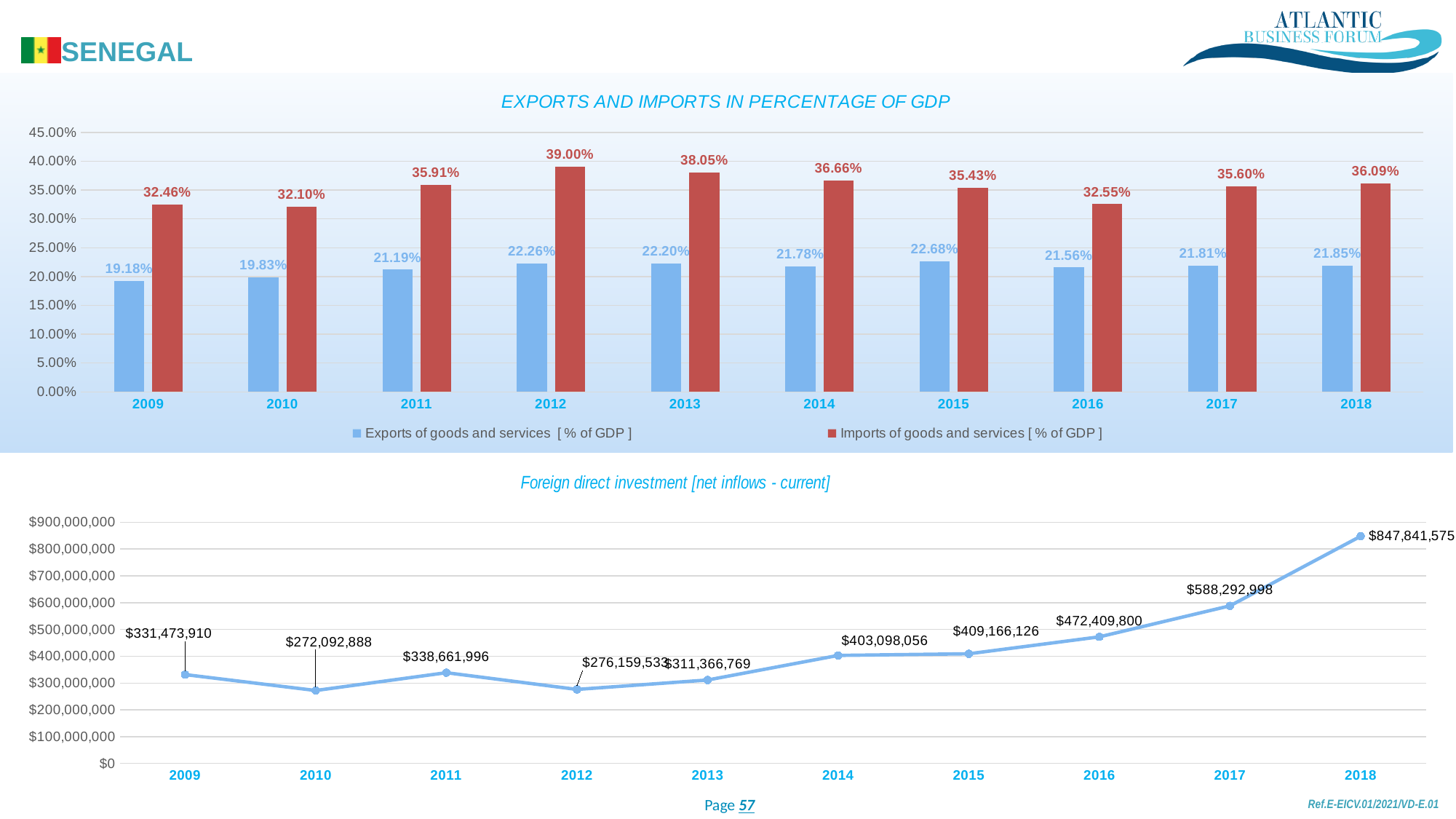
In the 'EXPORTS AND IMPORTS IN PERCENTAGE OF GDP' chart, what is the difference between imports and exports in 2012? 16.74% In the 'EXPORTS AND IMPORTS IN PERCENTAGE OF GDP' chart, what is the value of imports of goods and services in 2012? 39.00% In the 'EXPORTS AND IMPORTS IN PERCENTAGE OF GDP' chart, which year has the highest imports value? 2012 In the 'Foreign direct investment [net inflows - current]' chart, what is the value for 2018? $847,841,575 In the 'Foreign direct investment [net inflows - current]' chart, do the values rise or fall from 2013 to 2018? Rise In the 'Foreign direct investment [net inflows - current]' chart, how many years are plotted? 10 What type of chart is the 'EXPORTS AND IMPORTS IN PERCENTAGE OF GDP' chart? Bar chart In the 'EXPORTS AND IMPORTS IN PERCENTAGE OF GDP' chart, how many series does the legend list? 2 In the 'Foreign direct investment [net inflows - current]' chart, what is the difference between the 2018 and 2017 values? $259,548,577 In the 'Foreign direct investment [net inflows - current]' chart, which year has the lowest value? 2010 In the 'EXPORTS AND IMPORTS IN PERCENTAGE OF GDP' chart, which year has the lowest exports value? 2009 In the 'EXPORTS AND IMPORTS IN PERCENTAGE OF GDP' chart, what is the value of exports of goods and services in 2009? 19.18%